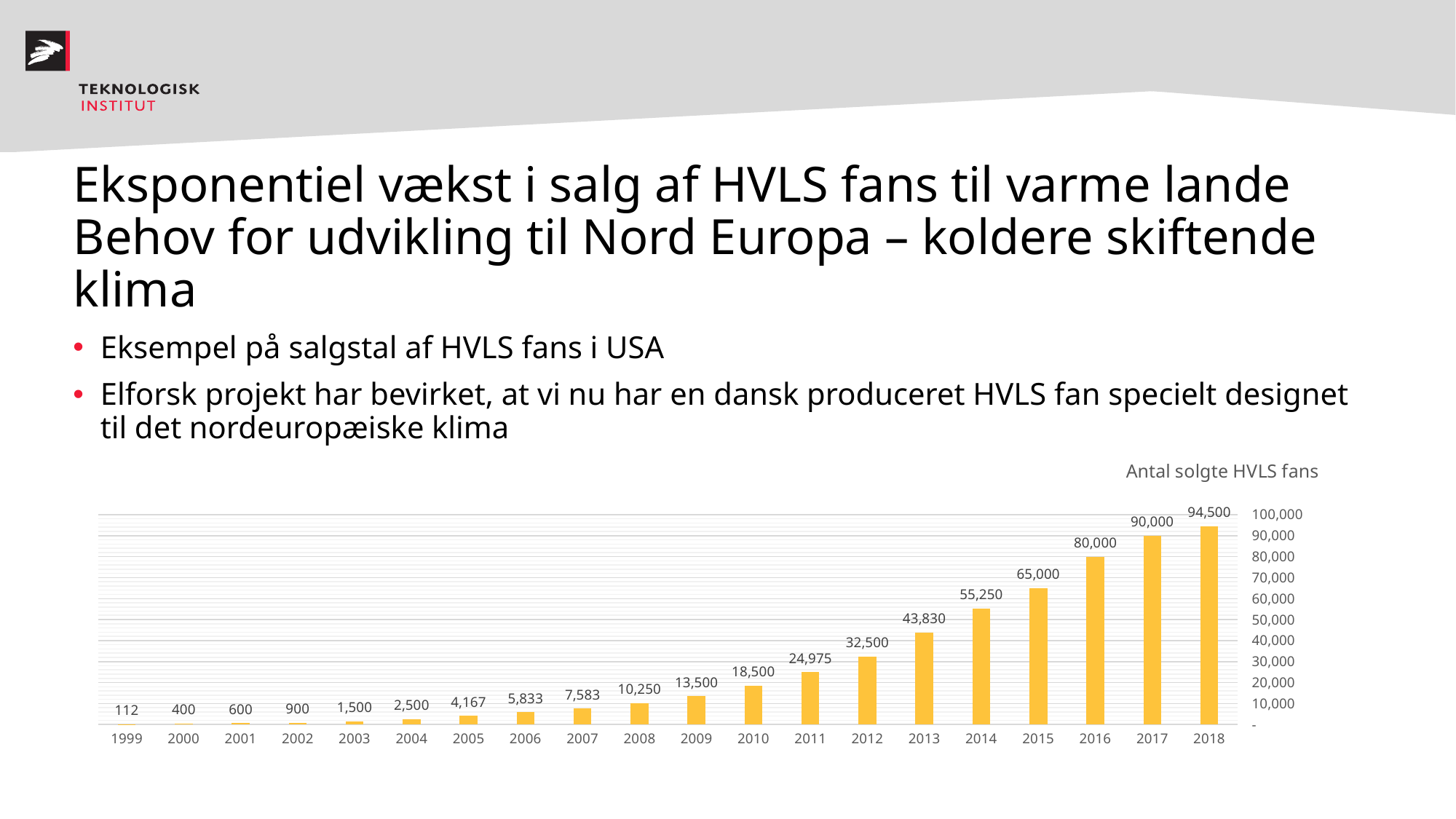
What is the value for 2010? 18,500 What is the value for 2005? 4,167 How many years are shown on the x axis? 20 What is the difference between the values for 2013 and 2012? 11,330 What is the value for 2016? 80,000 Is the value for 2013 greater or less than 40,000? greater Do the values rise or fall from 1999 to 2018? rise Which year has the lowest value? 1999 Which year has the highest value? 2018 Which is larger, the value for 2014 or the value for 2015? 2015 What is the difference between the values for 2018 and 2017? 4,500 What kind of chart is this? bar chart